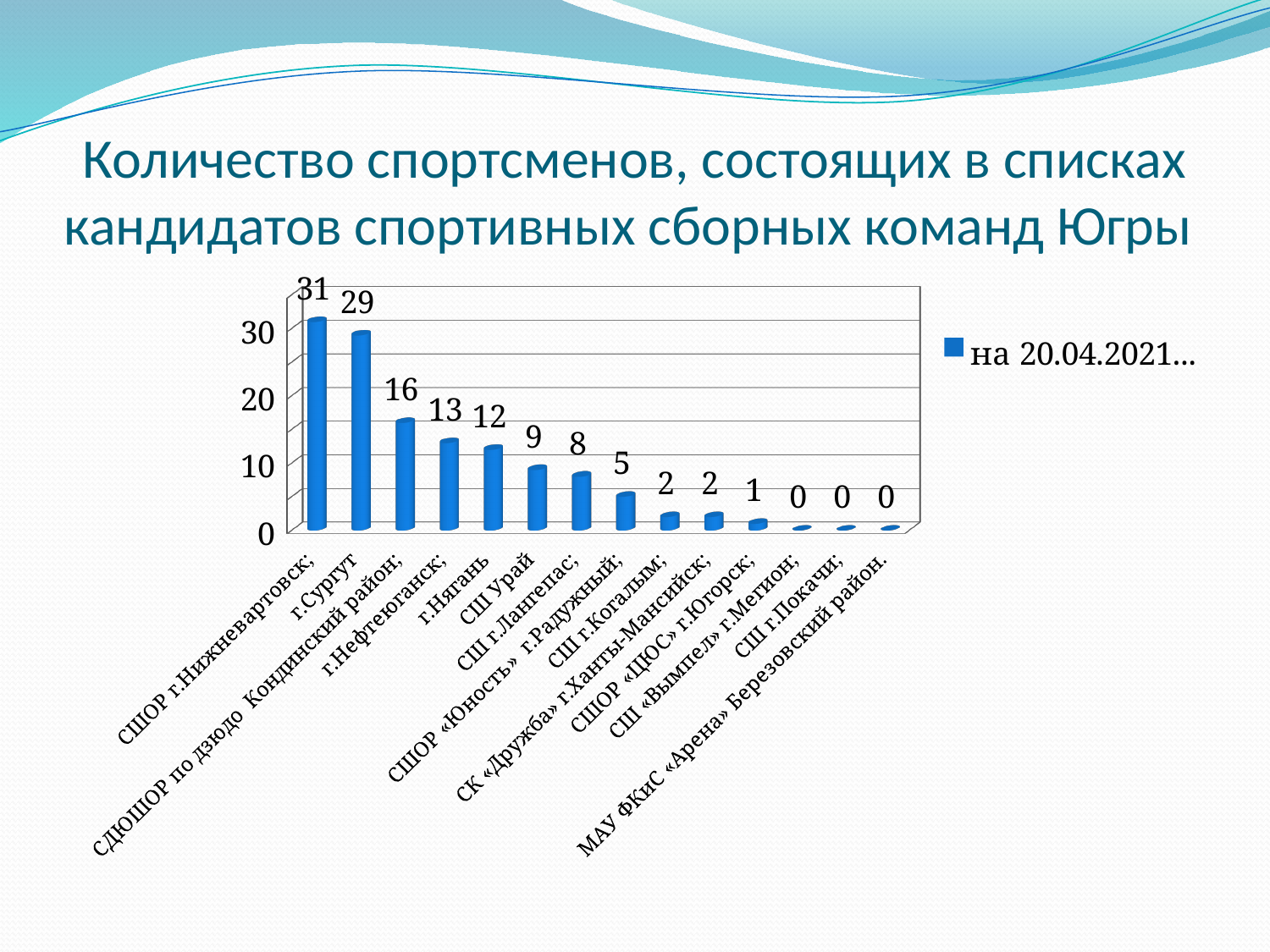
How many categories are shown on the x axis? 14 What is the value for СШ Урай? 9 Do the values rise or fall from left to right along the x axis? fall What kind of chart is shown on the slide? bar chart What is the value for СШОР г.Нижневартовск? 31 How many series does the legend list? 1 What is the value for г.Сургут? 29 What is the difference between the values for СШОР г.Нижневартовск and г.Сургут? 2 Which category has the highest value? СШОР г.Нижневартовск What is the value for СДЮШОР по дзюдо Кондинский район? 16 What is the difference between the values for г.Нефтеюганск and г.Нягань? 1 Which is larger, the value for СШ г.Лангепас or the value for СШОР «Юность» г.Радужный? СШ г.Лангепас